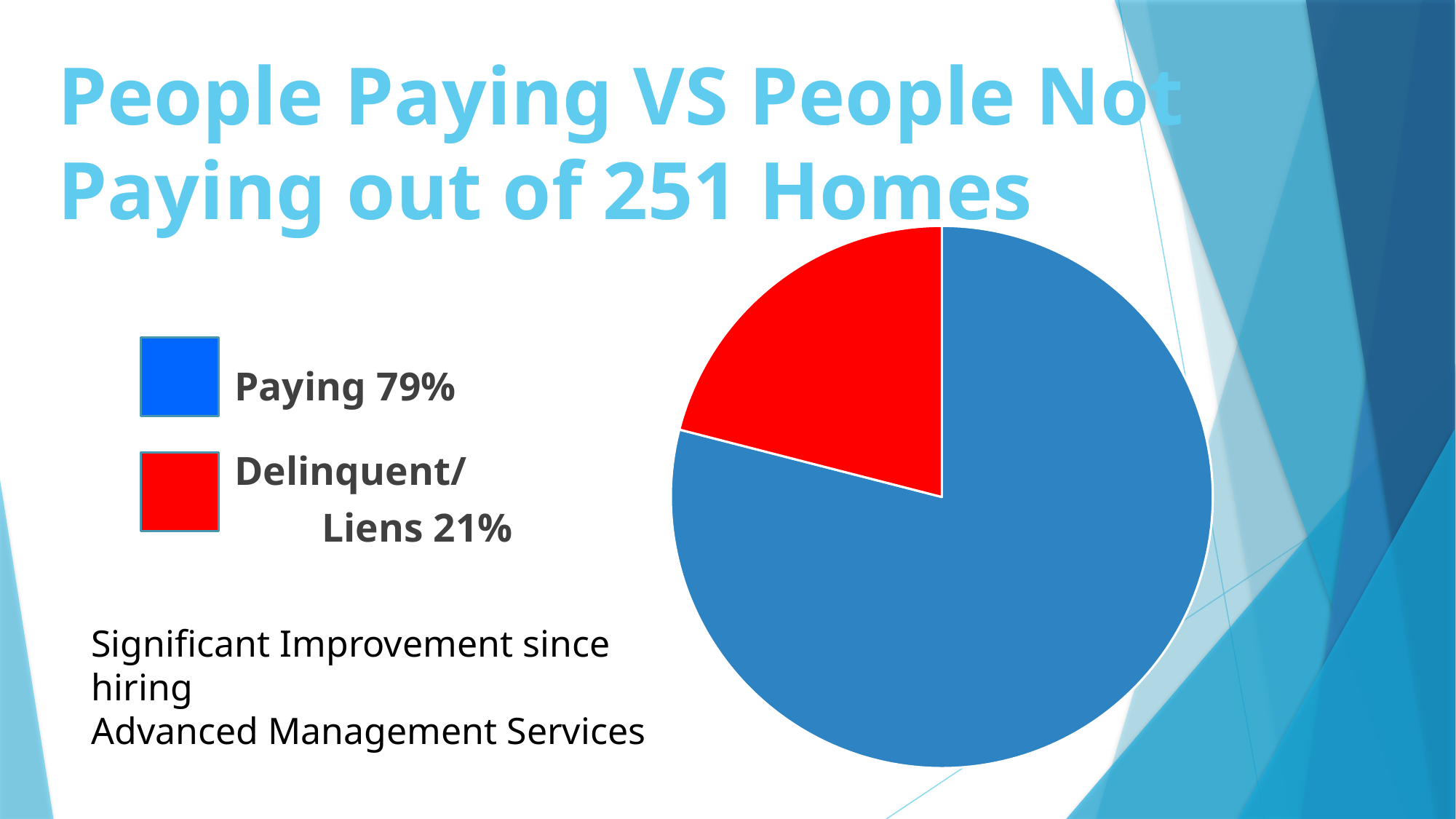
What kind of chart is shown on the slide? Pie chart Which category has the smallest slice of the pie? Delinquent/Liens How many entries does the legend list? 2 What share of the pie is labelled Paying? 79% By how many percentage points does the Paying share exceed the Delinquent/Liens share? 58 What colour is the Delinquent/Liens slice? Red What colour is the Paying slice? Blue How many slices does the pie chart have? 2 How many homes in total does the chart title say the data covers? 251 What share of the pie is labelled Delinquent/Liens? 21% Which is larger, the Paying share or the Delinquent/Liens share? Paying Which category has the largest slice of the pie? Paying